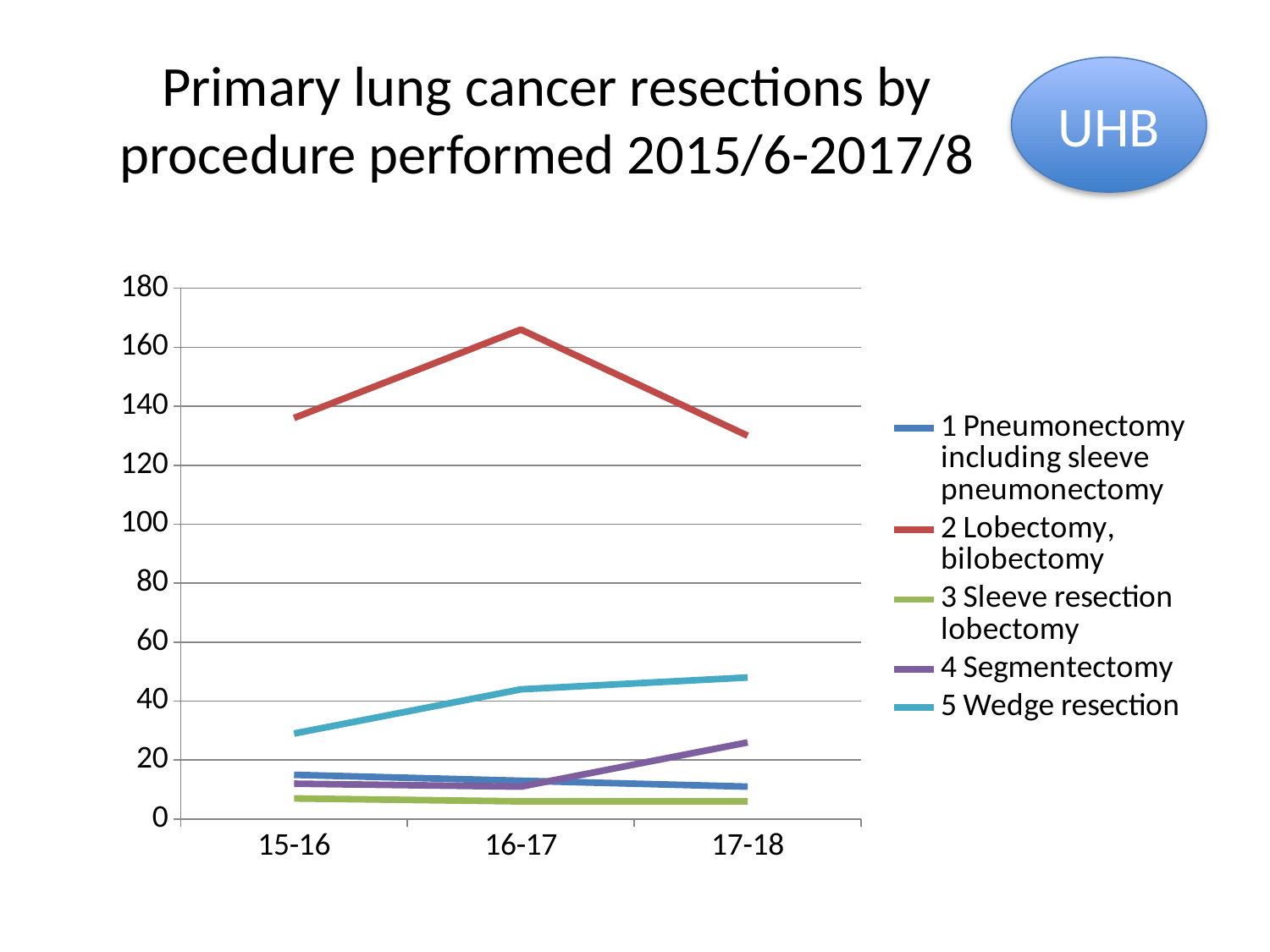
In 17-18, which is larger: 4 Segmentectomy or 1 Pneumonectomy including sleeve pneumonectomy? 4 Segmentectomy Is the value for 2 Lobectomy, bilobectomy in 17-18 greater or less than 120? greater Does the 5 Wedge resection line rise or fall from 15-16 to 17-18? rise Is the value for 5 Wedge resection in 15-16 greater or less than 40? less Which procedure has the highest number of resections in every year shown? 2 Lobectomy, bilobectomy Which procedure has the lowest number of resections in 17-18? 3 Sleeve resection lobectomy What kind of chart is shown on the slide? line chart What is the title of the chart on the slide? Primary lung cancer resections by procedure performed 2015/6-2017/8 Is the value for 2 Lobectomy, bilobectomy in 16-17 greater or less than 160? greater How many time periods are shown on the x axis? 3 How many series does the legend list? 5